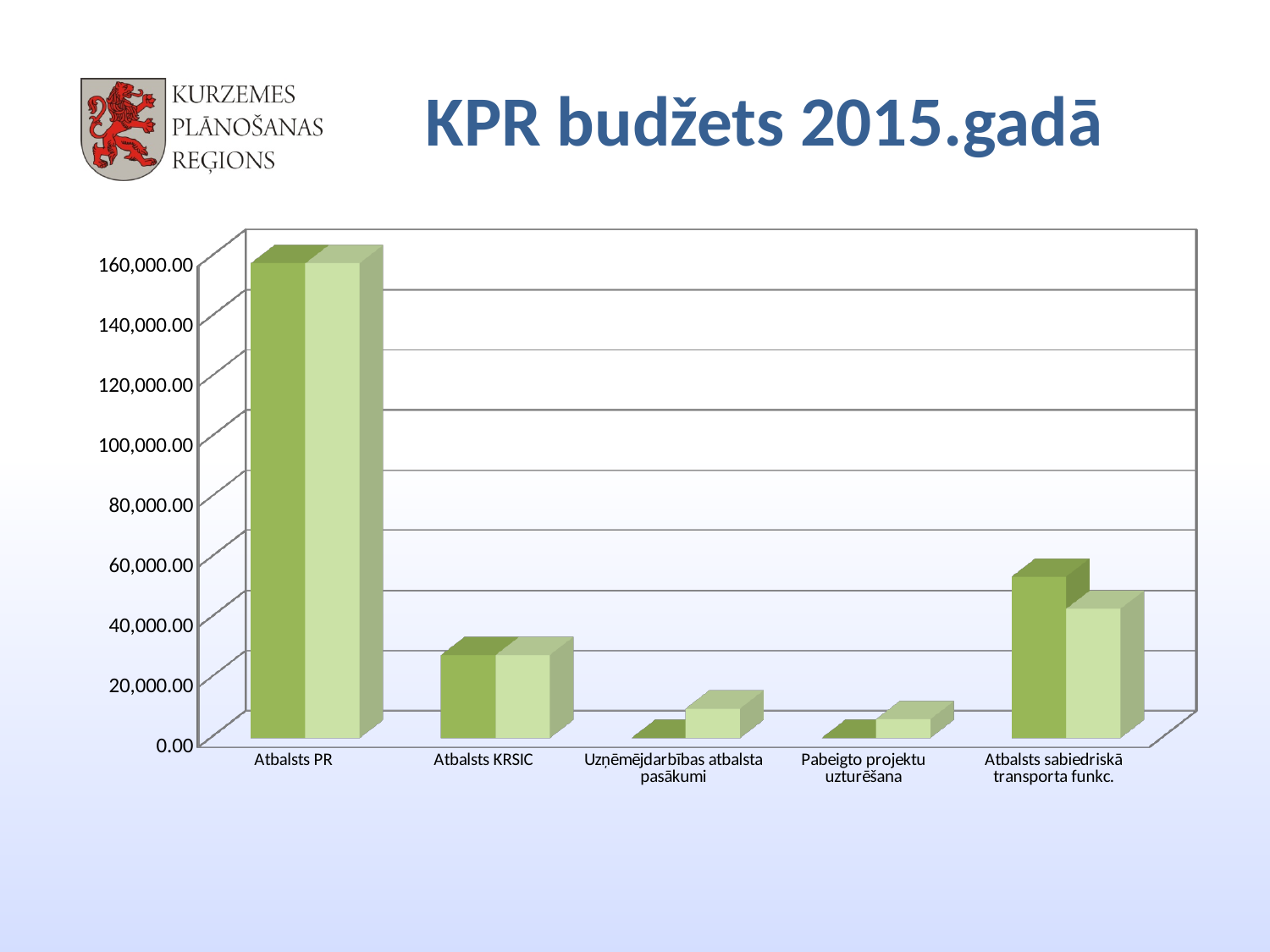
Is the value for Uzņēmējdarbības atbalsta pasākumi greater or less than 20,000.00? less Is the value for Pabeigto projektu uzturēšana greater or less than 20,000.00? less What is the title of the slide's chart? KPR budžets 2015.gadā Which category has the highest value in the chart? Atbalsts PR How many categories are shown on the x axis of the chart? 5 Is the value for Atbalsts sabiedriskā transporta funkc. greater or less than 40,000.00? greater Which is larger: the value for Atbalsts PR or the value for Atbalsts KRSIC? Atbalsts PR Which is larger: the value for Atbalsts KRSIC or the value for Atbalsts sabiedriskā transporta funkc.? Atbalsts sabiedriskā transporta funkc. What kind of chart is shown on the slide? Bar chart